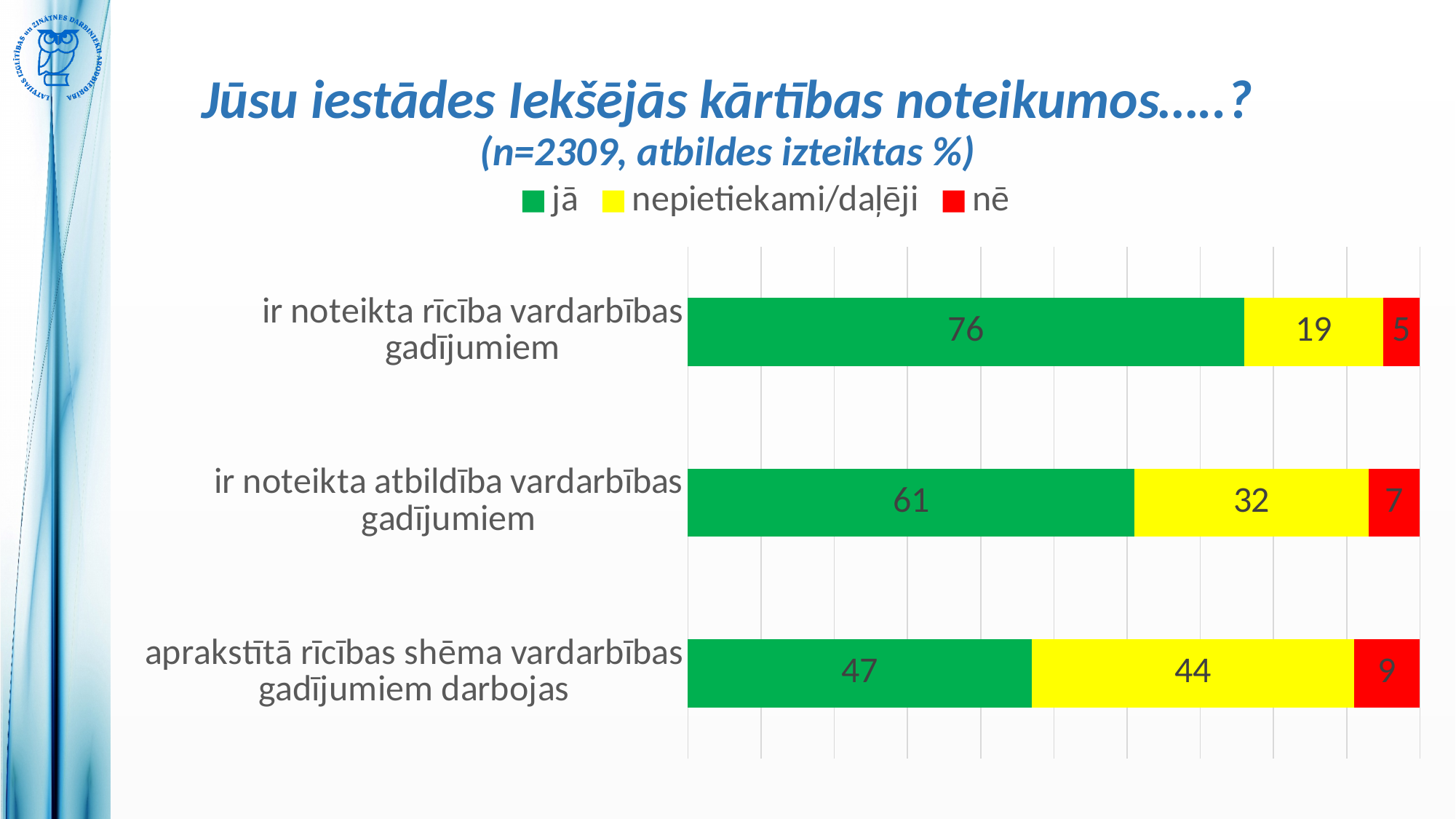
What is the "nē" value for "aprakstītā rīcības shēma vardarbības gadījumiem darbojas"? 9 What is the "nepietiekami/daļēji" value for "ir noteikta atbildība vardarbības gadījumiem"? 32 What is the total of the stacked bar for "ir noteikta atbildība vardarbības gadījumiem"? 100 What is the "jā" value for "ir noteikta rīcība vardarbības gadījumiem"? 76 Which category has the lowest "nē" value? ir noteikta rīcība vardarbības gadījumiem How many series does the legend list? 3 What is the difference between the "jā" values for "ir noteikta rīcība vardarbības gadījumiem" and "aprakstītā rīcības shēma vardarbības gadījumiem darbojas"? 29 What kind of chart is shown on the slide? stacked bar chart Which category has the highest "jā" value? ir noteikta rīcība vardarbības gadījumiem Which is larger: the "nepietiekami/daļēji" value for "ir noteikta atbildība vardarbības gadījumiem" or for "aprakstītā rīcības shēma vardarbības gadījumiem darbojas"? aprakstītā rīcības shēma vardarbības gadījumiem darbojas How many categories are shown in the chart? 3 Which colour represents the "nē" series in the legend? red